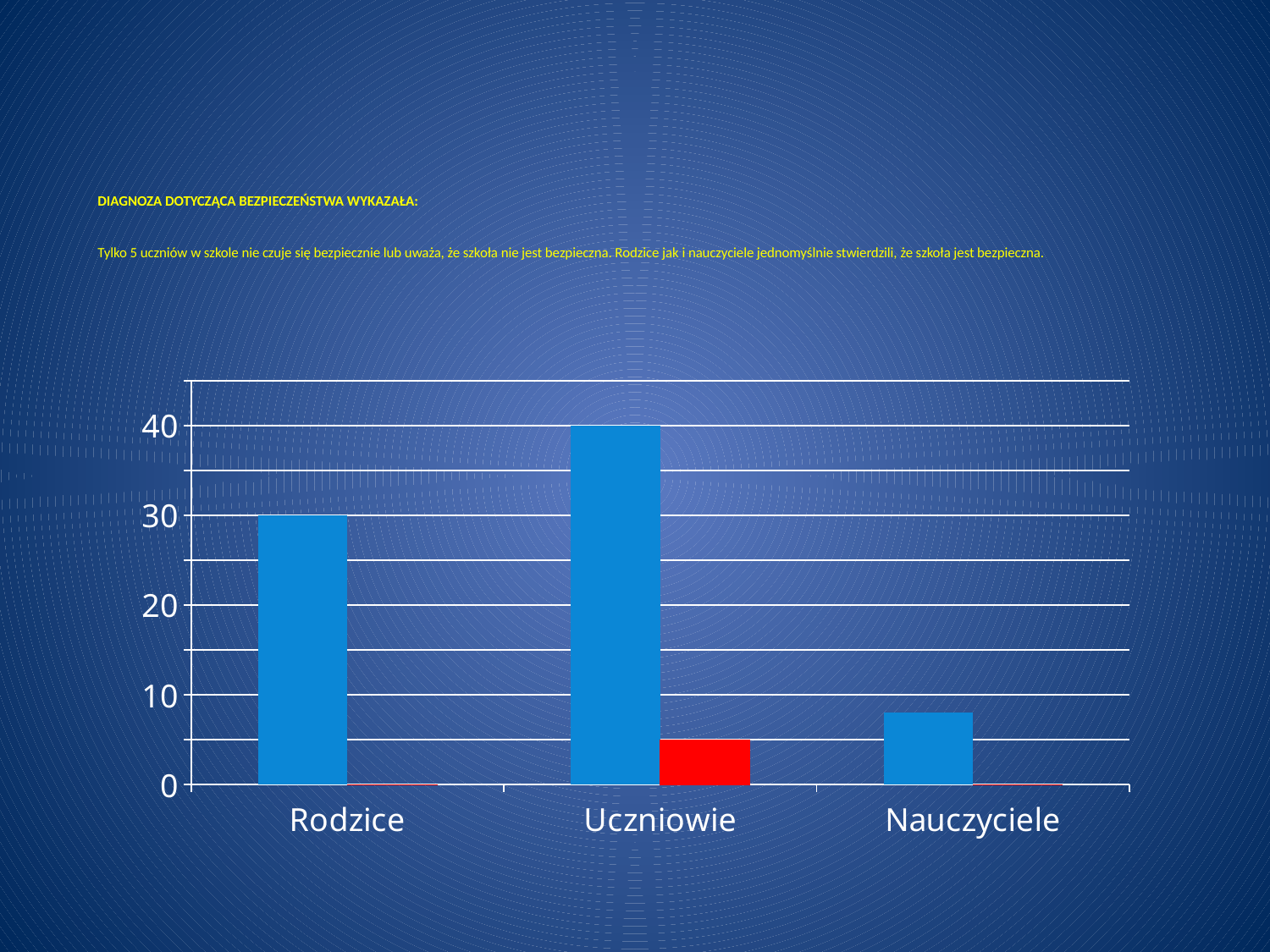
How many categories are shown on the x axis of the chart? 3 Is the value of the red bar for Uczniowie greater or less than 10? less What kind of chart is shown on the slide? bar chart Is the value of the blue bar for Nauczyciele greater or less than 10? less What is the highest labelled value on the vertical axis? 40 Which category has a red bar next to its blue bar? Uczniowie Which blue bar is taller, Rodzice or Nauczyciele? Rodzice What is the difference between the blue bar for Uczniowie and the blue bar for Rodzice? 10 Which category has the tallest bar? Uczniowie Which category has the lowest blue bar? Nauczyciele What is the value of the blue bar for Uczniowie? 40 What is the value of the blue bar for Rodzice? 30